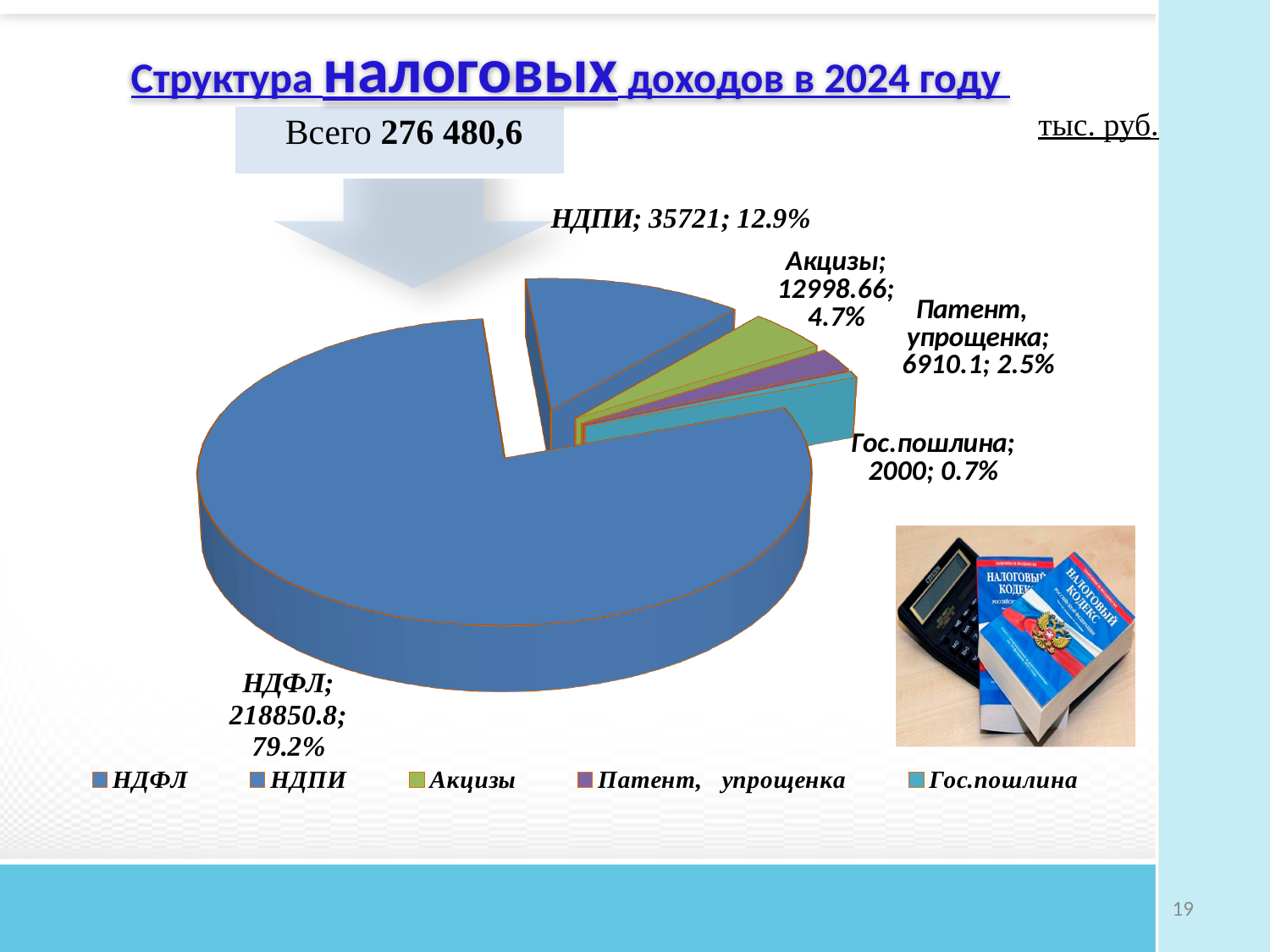
Which category has the smallest slice? Гос.пошлина Which is larger, НДПИ or Акцизы? НДПИ What is the value for Акцизы? 12998.66 What share of the pie does Патент, упрощенка represent? 2.5% What is the value for НДПИ? 35721 What is the value for Гос.пошлина? 2000 What total is shown above the chart? 276 480,6 What share of the pie does НДФЛ represent? 79.2% Which category has the largest slice? НДФЛ How many categories does the pie chart have? 5 What is the value for НДФЛ? 218850.8 What kind of chart is shown on the slide? pie chart